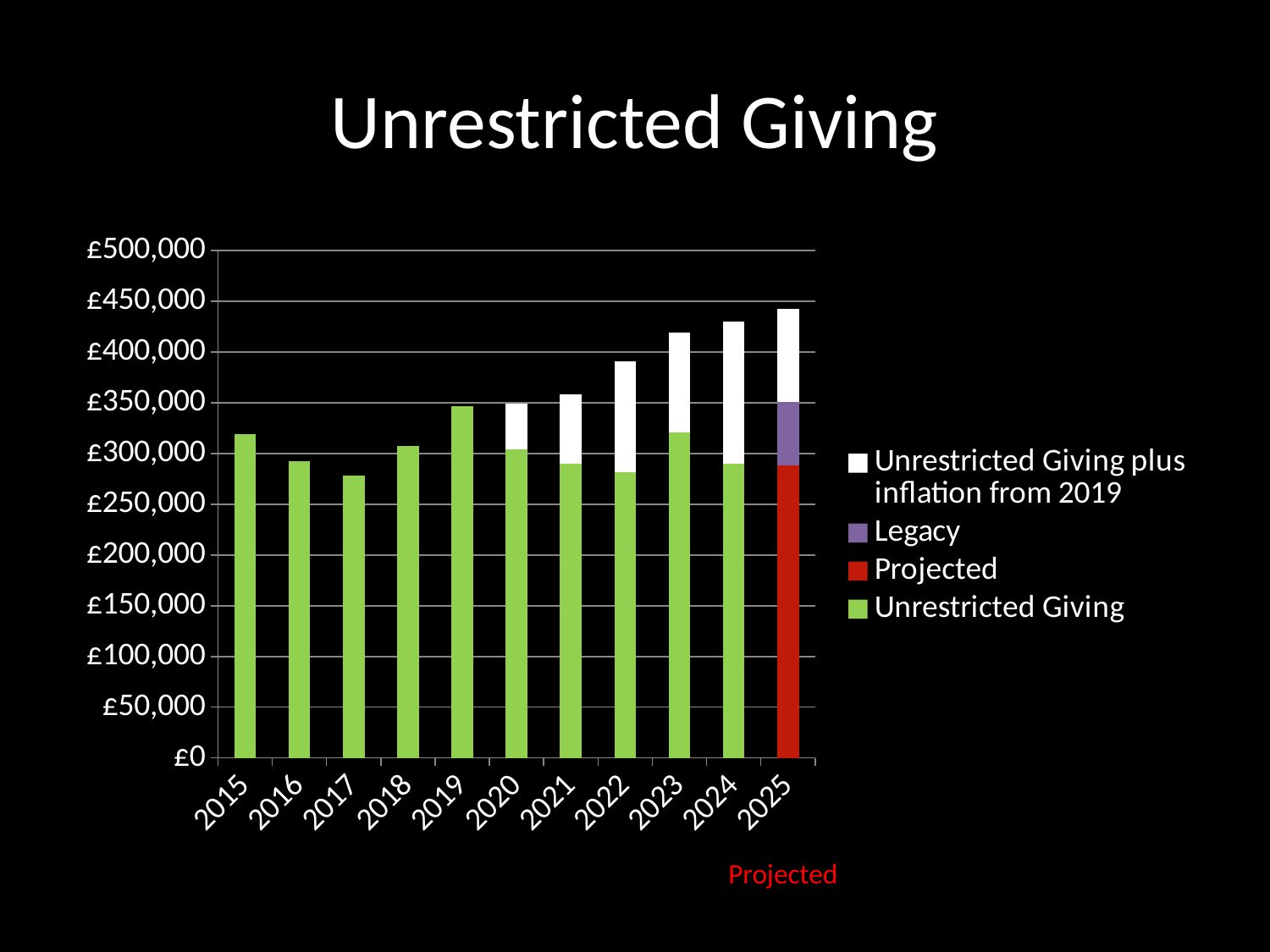
How many series does the chart's legend list? 4 Which colour represents the Projected series in the chart? red Which year has the tallest stacked bar overall? 2025 Is the Unrestricted Giving value for 2019 greater or less than £300,000? greater What kind of chart is shown on the slide? bar chart What is the title of the chart? Unrestricted Giving Is the Unrestricted Giving value for 2015 greater or less than £300,000? greater Which year has the highest Unrestricted Giving (green) value? 2019 Does the top of the stacked bars rise or fall from 2020 to 2025? rise Is the total height of the stacked bar for 2023 greater or less than £400,000? greater How many years are shown on the x axis of the chart? 11